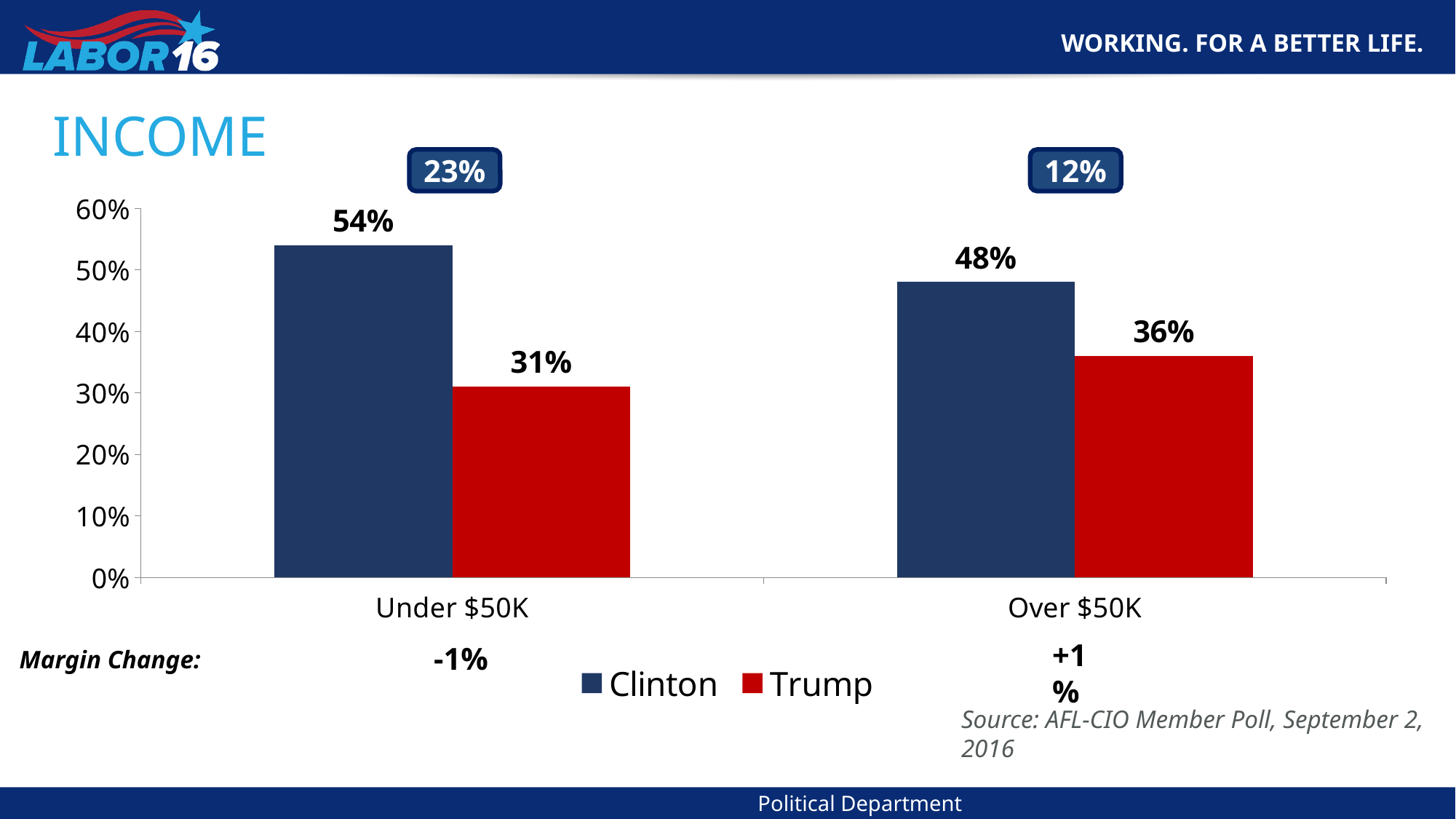
What is Clinton's value for Over $50K? 48% How many series does the legend list? 2 What is Trump's value for Under $50K? 31% Which income group has the highest Clinton value? Under $50K What is Trump's value for Over $50K? 36% What kind of chart is shown on the slide? Bar chart Which is larger for Over $50K, Clinton or Trump? Clinton Which income group has the lowest Trump value? Under $50K What is the difference between Clinton's and Trump's values for Under $50K? 23% What is the difference between Clinton's and Trump's values for Over $50K? 12% How many income categories are shown on the x axis? 2 What is Clinton's value for Under $50K? 54%